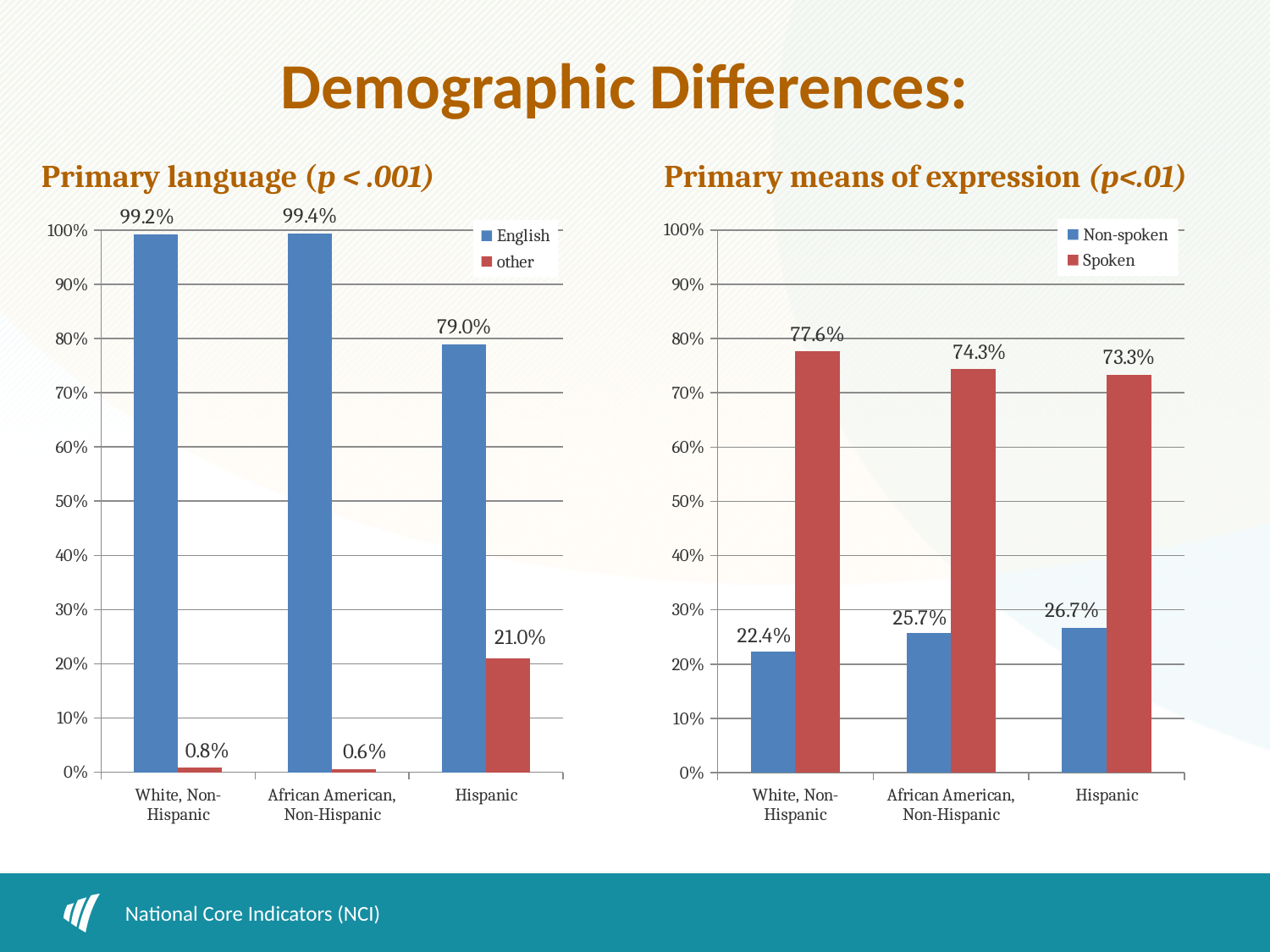
In the Primary means of expression chart, which category has the highest Spoken value? White, Non-Hispanic In the Primary means of expression chart, what is the difference between the Spoken and Non-spoken values for Hispanic? 46.6% In the Primary means of expression chart, what is the Non-spoken value for White, Non-Hispanic? 22.4% In the Primary language chart, which category has the highest 'other' value? Hispanic In the Primary language chart, what is the English value for Hispanic? 79.0% What kind of chart is the Primary language chart? Bar chart In the Primary language chart, what is the 'other' value for White, Non-Hispanic? 0.8% In the Primary language chart, what is the difference between the English values for African American, Non-Hispanic and Hispanic? 20.4% In the Primary means of expression chart, what is the Spoken value for African American, Non-Hispanic? 74.3% In the Primary language chart, which category has the lowest English value? Hispanic In the Primary means of expression chart, how many series does the legend list? 2 In the Primary means of expression chart, which category has the highest Non-spoken value? Hispanic